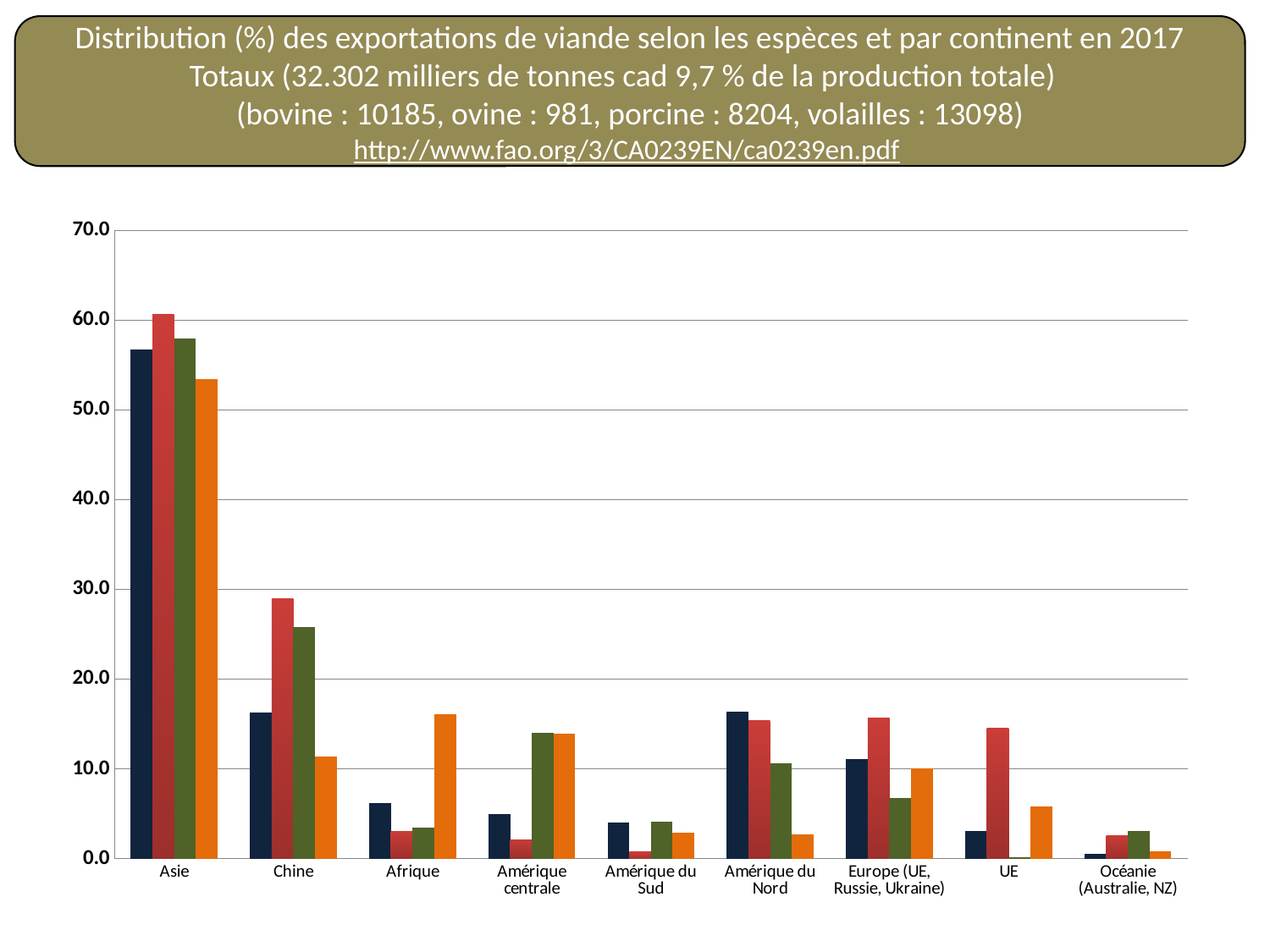
How many bars (series) are plotted for each category in the chart? 4 Is the value of the dark blue bar for Chine greater or less than 20? less How many categories are shown along the x axis of the chart? 9 Is the value of the orange bar for Afrique greater or less than 10? greater Which is larger: the red bar for Asie or the red bar for Chine? Asie Which is larger for Afrique: the orange bar or the dark blue bar? the orange bar What kind of chart is shown on the slide? bar chart Is the value of the red bar for Chine greater or less than 20? greater What is the highest value shown on the y axis of the chart? 70.0 Which category has the tallest bars in the chart? Asie